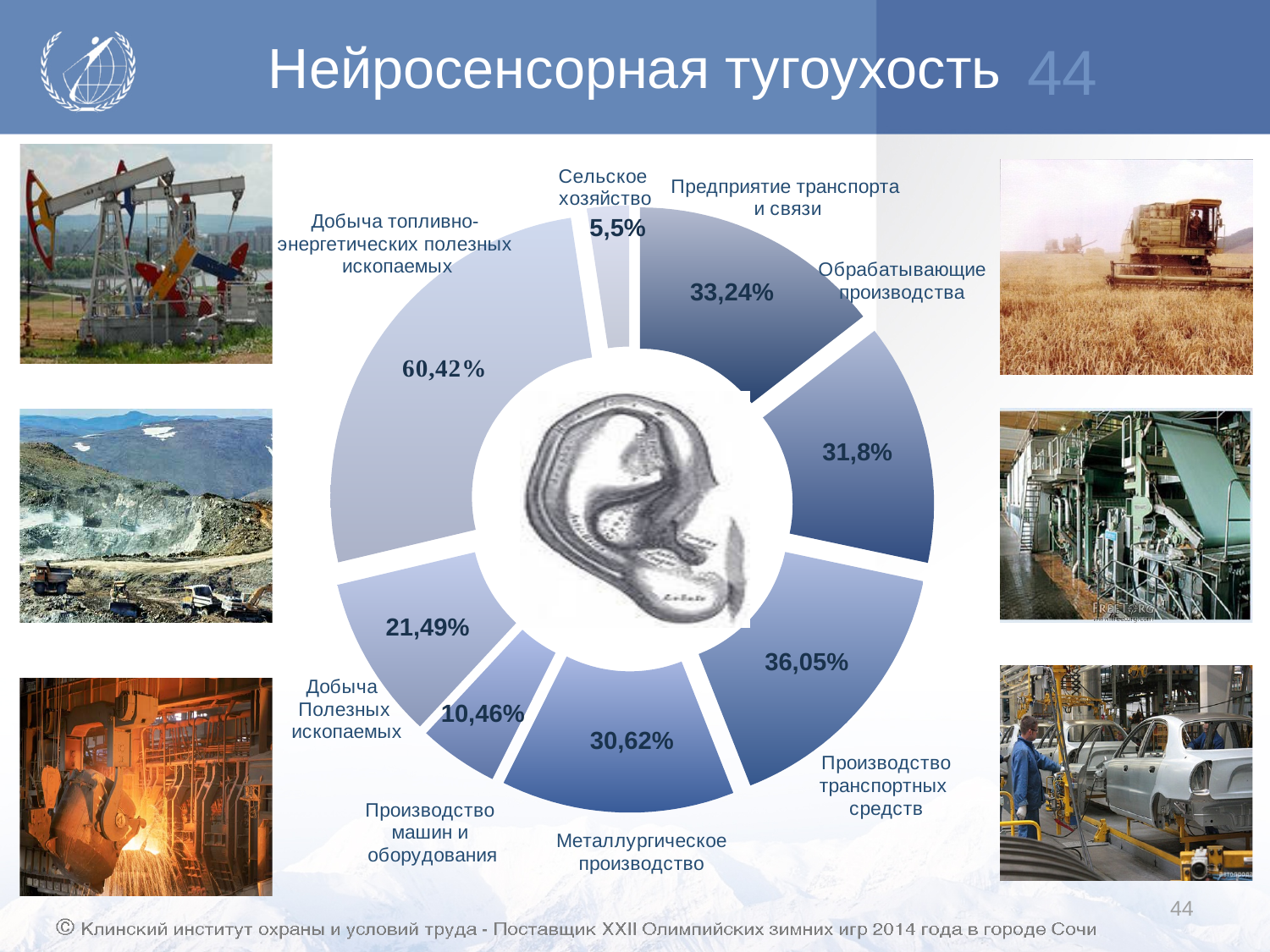
What is the value for Производство машин и оборудования? 10,46% What is the value for Добыча топливно-энергетических полезных ископаемых? 60,42% What kind of chart is shown on the slide? Doughnut chart How many categories are shown in the chart? 8 What is the value for Производство транспортных средств? 36,05% What is the title of the slide containing the chart? Нейросенсорная тугоухость Which is larger: Предприятие транспорта и связи or Обрабатывающие производства? Предприятие транспорта и связи What is the difference between Добыча топливно-энергетических полезных ископаемых and Добыча полезных ископаемых? 38,93% What is the value for Металлургическое производство? 30,62% Which category has the highest value? Добыча топливно-энергетических полезных ископаемых Which category has the lowest value? Сельское хозяйство What is the value for Сельское хозяйство? 5,5%